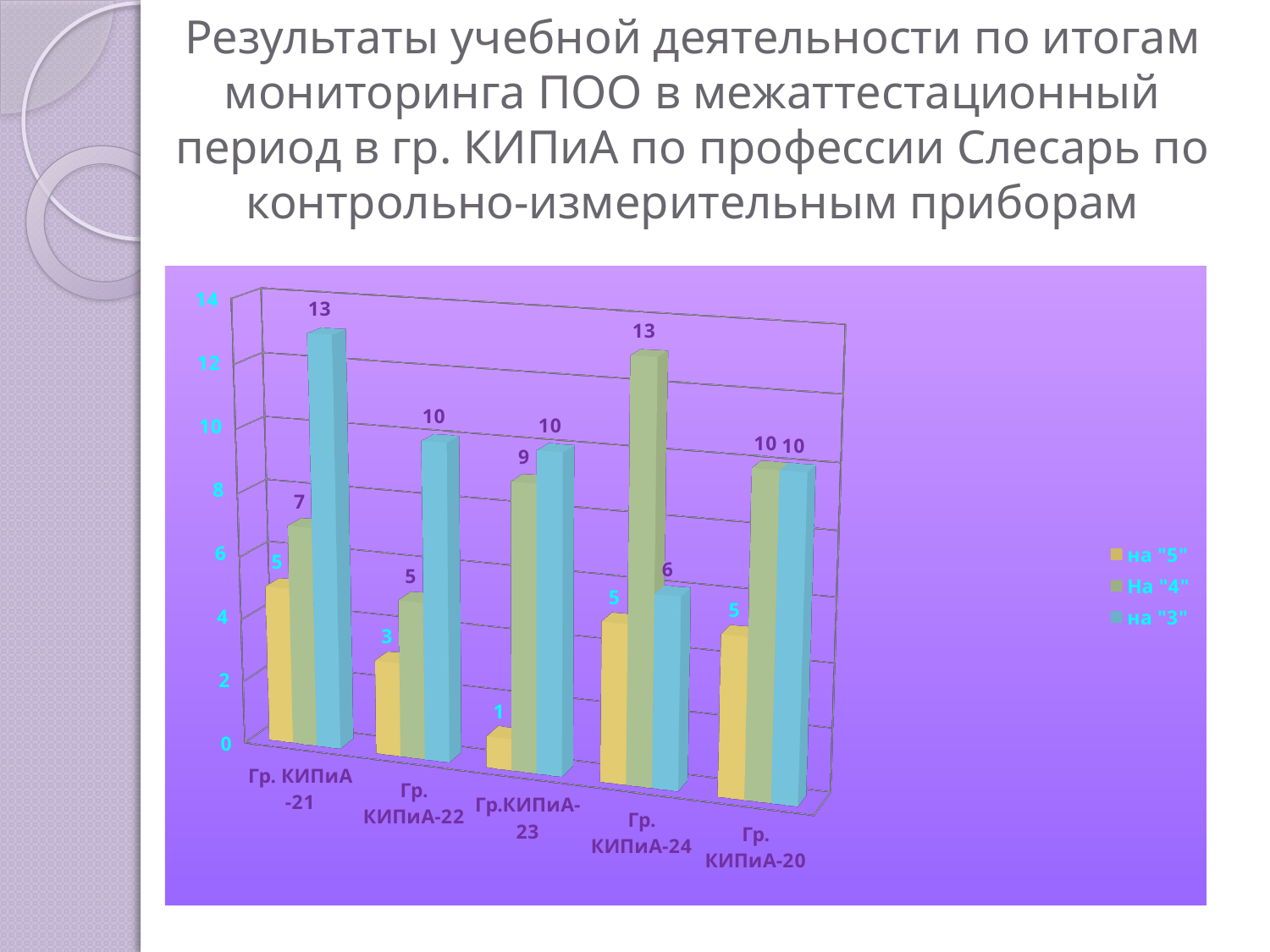
What is the value for на "3" in Гр. КИПиА-21? 13 What is the value for на "3" in Гр. КИПиА-22? 10 What kind of chart is shown on the slide? Bar chart Which is larger in Гр. КИПиА-24: the На "4" value or the на "3" value? На "4" How many groups are shown on the x axis? 5 What is the value for на "5" in Гр.КИПиА-23? 1 What colour are the bars for the series на "3"? Blue What is the difference between the на "3" value and the на "5" value in Гр. КИПиА-21? 8 Which group has the highest value for На "4"? Гр. КИПиА-24 How many series does the legend list? 3 Which group has the lowest value for на "5"? Гр.КИПиА-23 What is the value for На "4" in Гр. КИПиА-24? 13